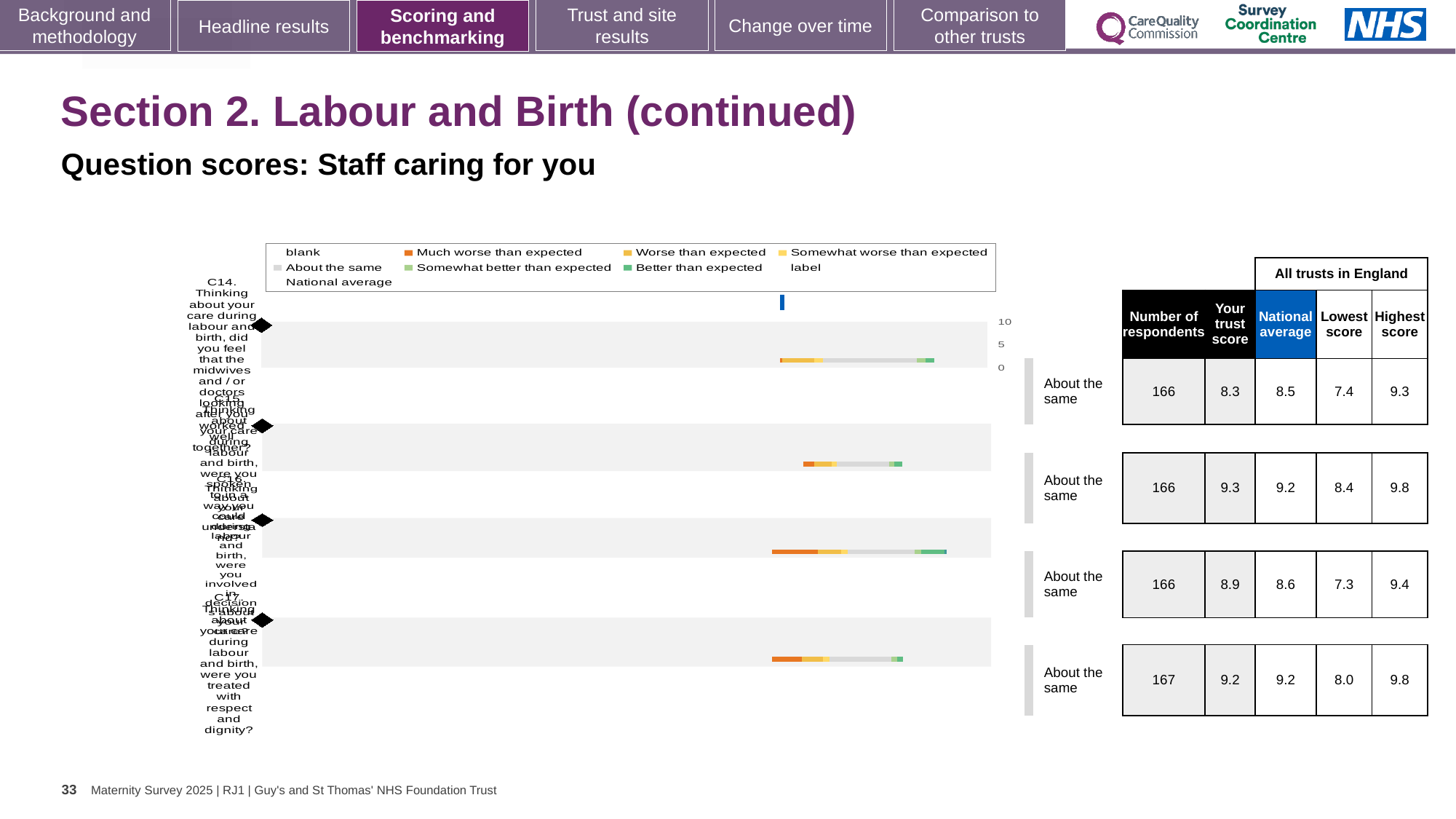
For the first question row (C14), which is larger: the trust score or the national average? the national average (8.5) Which question row has the lowest 'Your trust score'? the first row, C14 (8.3) What benchmark category is shown for all four question rows? About the same For the fourth question row (C17), what is the difference between the highest score and the lowest score? 1.8 What is the 'Your trust score' for the first question row (C14)? 8.3 What is the national average for the second question row? 9.2 What colour does the legend use for 'Much worse than expected'? orange How many question rows (bars) are plotted in the chart? 4 How many respondents are recorded for the fourth question row (C17)? 167 Which question row has the highest 'Your trust score'? the second row (9.3) What kind of chart is shown on the slide? bar chart How many entries does the chart legend list? 9